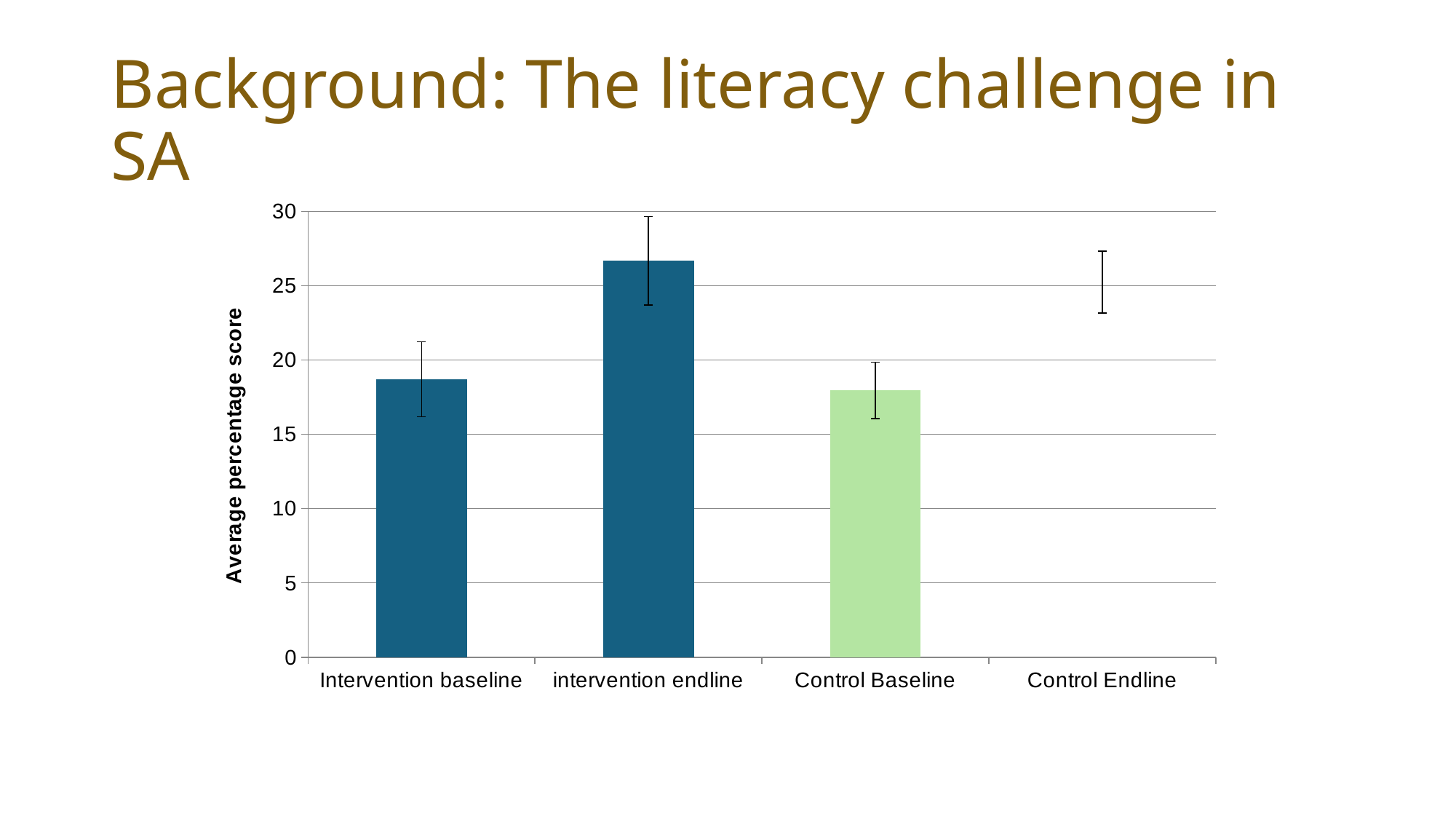
Is the value for Control Baseline greater or less than 20? less How many categories are shown on the x axis of the chart? 4 What kind of chart is shown on the slide? bar chart Is the value for Intervention baseline greater or less than 15? greater Which category has the tallest bar in the chart? intervention endline Which is larger, the value for intervention endline or the value for Intervention baseline? intervention endline What is the label of the vertical axis of the chart? Average percentage score Is the value for intervention endline greater or less than 25? greater What colour is the Control Baseline bar? light green Which is larger, the value for intervention endline or the value for Control Baseline? intervention endline